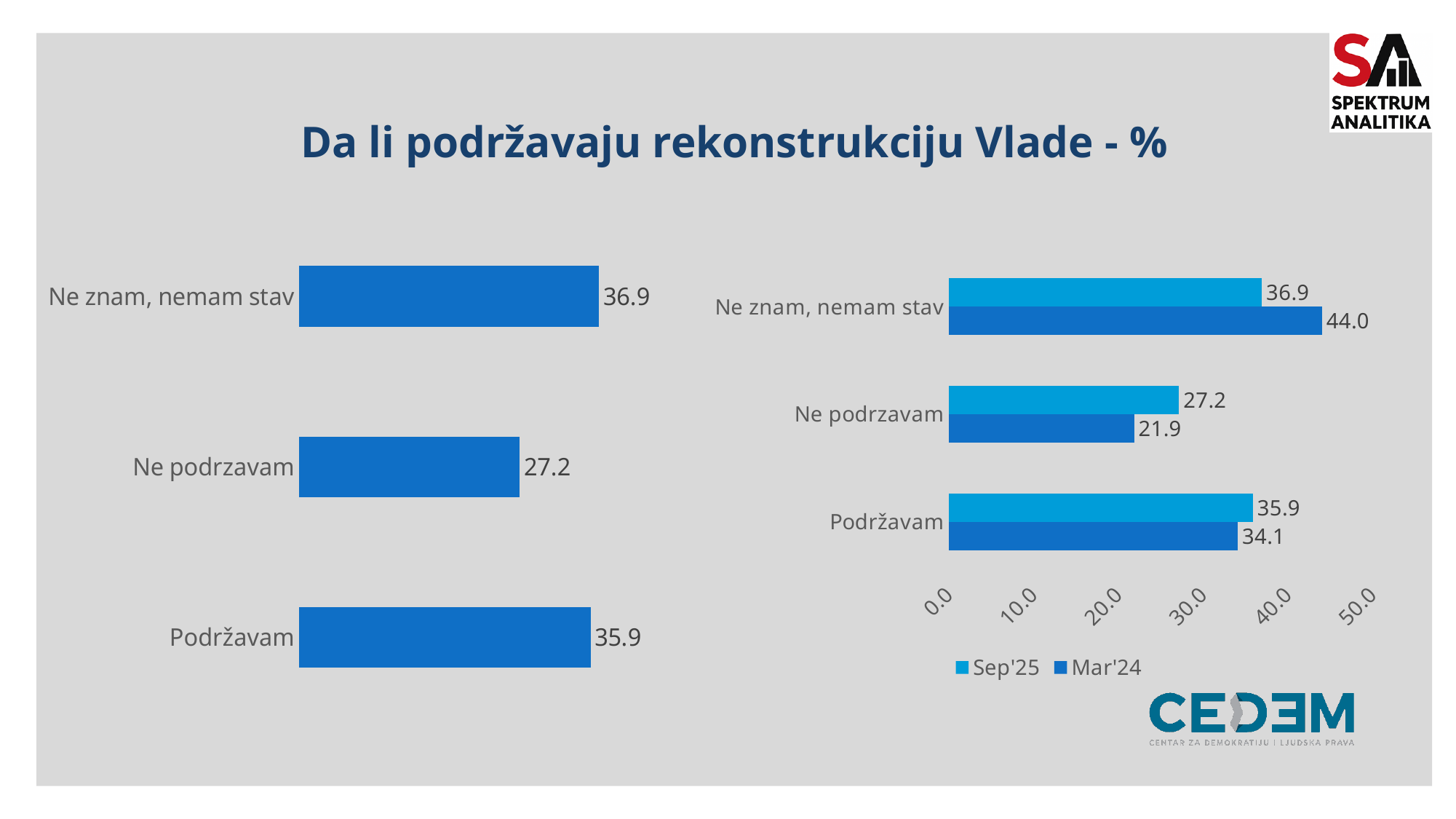
In the right chart, which is larger for Ne podrzavam: Sep'25 or Mar'24? Sep'25 In the left chart, which category has the lowest value? Ne podrzavam In the right chart, what is the Sep'25 value for Podržavam? 35.9 In the right chart, what is the difference between the Mar'24 and Sep'25 values for Ne znam, nemam stav? 7.1 In the left chart, how many categories are shown? 3 In the left chart, what is the value for Ne podrzavam? 27.2 In the left chart, what is the value for Ne znam, nemam stav? 36.9 What is the title of the slide's chart? Da li podržavaju rekonstrukciju Vlade - % In the right chart, what is the Mar'24 value for Ne znam, nemam stav? 44.0 In the left chart, what is the difference between Ne znam, nemam stav and Podržavam? 1.0 What kind of chart is the right chart? Bar chart In the right chart, how many series does the legend list? 2